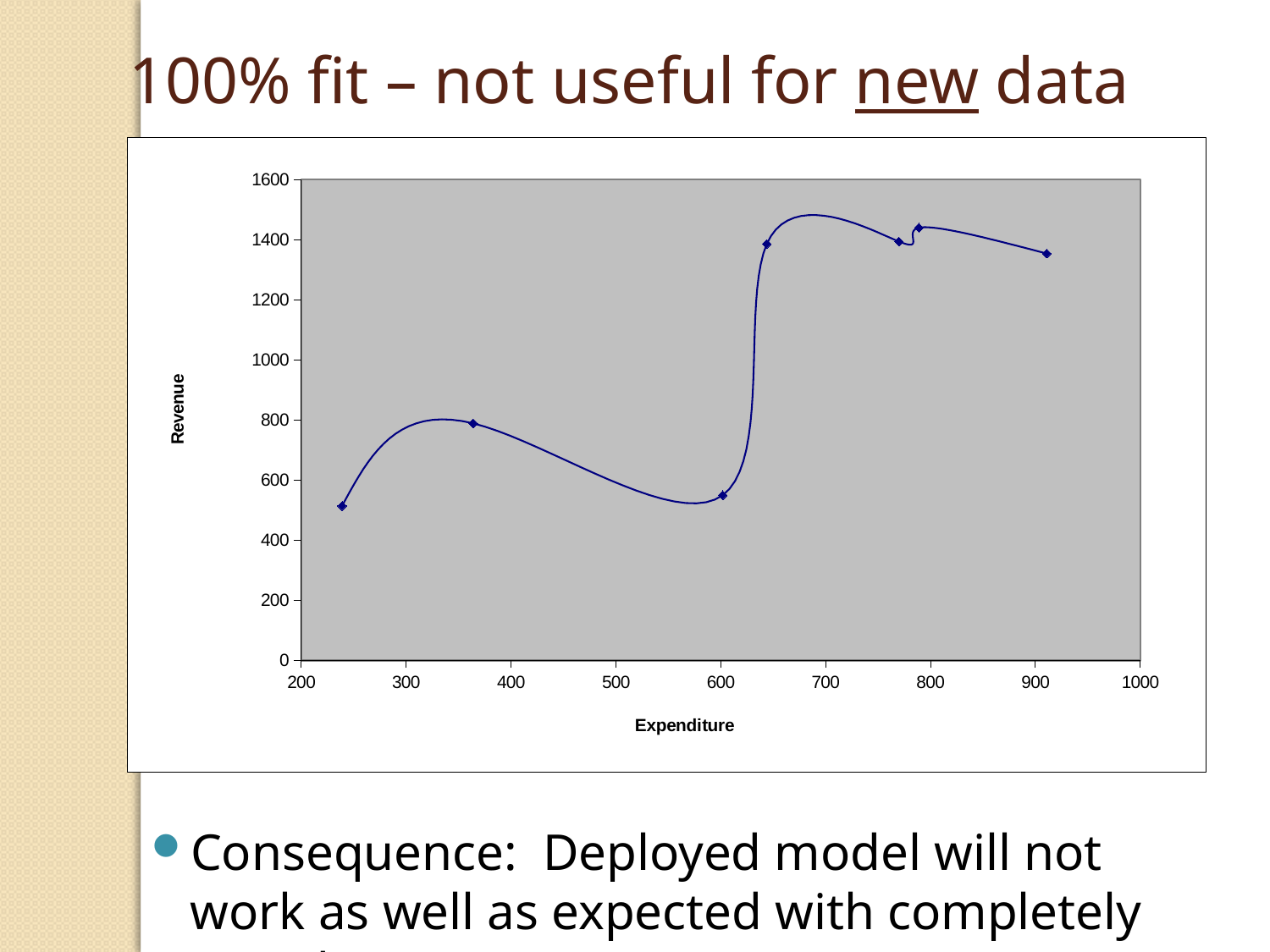
Does the curve rise or fall between the first data point (near expenditure 240) and the second data point (near expenditure 365)? rise Does the curve rise or fall between the data point near expenditure 800 and the data point near expenditure 910? fall Is the revenue for the data point with the lowest expenditure (near 240) greater or less than 600? less Is the revenue for the data point with the lowest expenditure (near 240) greater or less than 400? greater Is the revenue for the data point with the highest expenditure (near 910) greater or less than 1200? greater What is the label of the y axis? Revenue What is the label of the x axis? Expenditure How many data points are plotted on the chart? 7 What kind of chart is shown on the slide? scatter chart